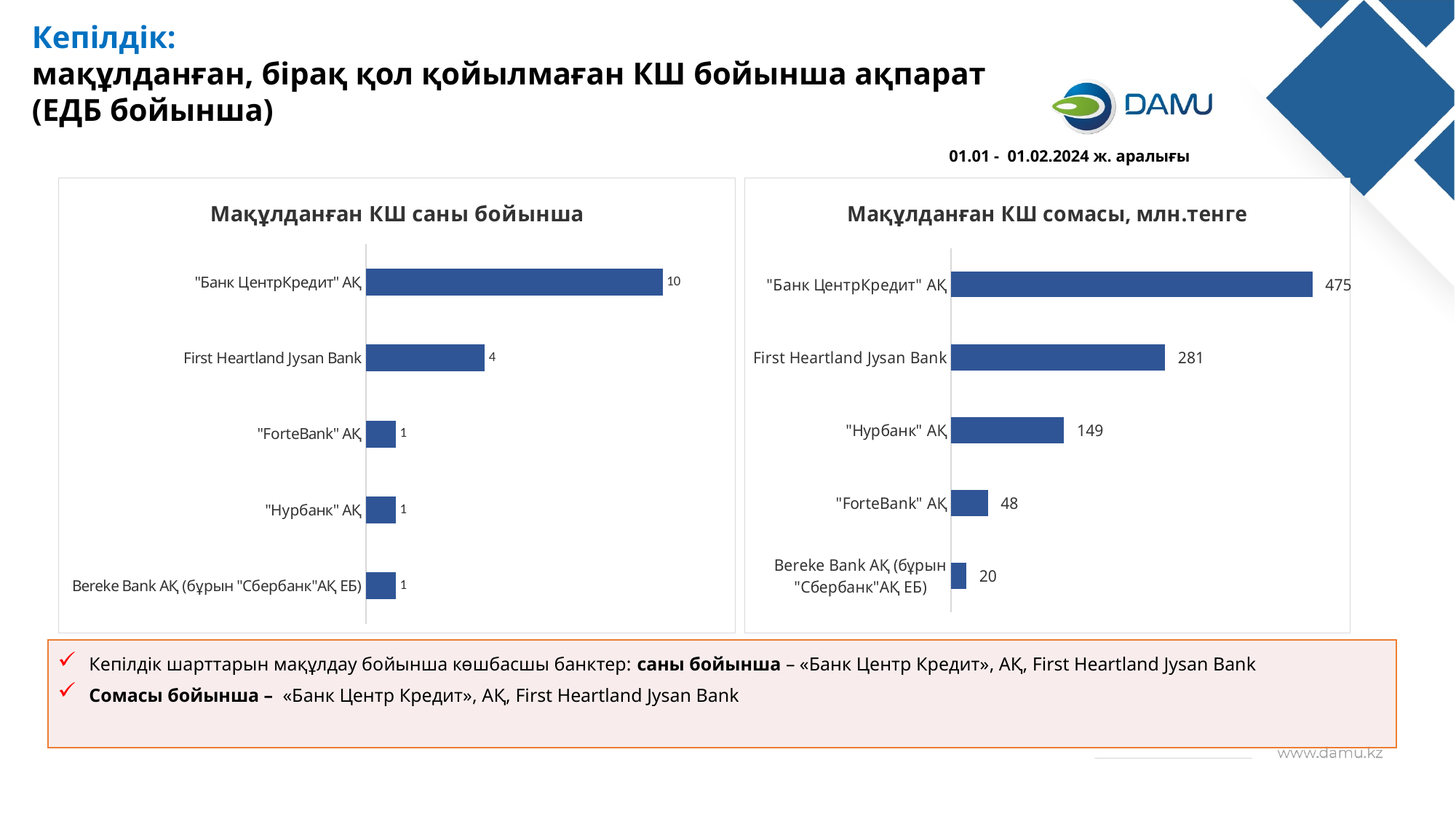
In the chart titled "Мақұлданған КШ саны бойынша", which bank has the highest value? "Банк ЦентрКредит" АҚ In the chart titled "Мақұлданған КШ сомасы, млн.тенге", which bank has the lowest value? Bereke Bank АҚ (бұрын "Сбербанк"АҚ ЕБ) In the chart titled "Мақұлданған КШ саны бойынша", what is the value for "Банк ЦентрКредит" АҚ? 10 What is the title of the left chart on the slide? Мақұлданған КШ саны бойынша In the chart titled "Мақұлданған КШ саны бойынша", what is the value for First Heartland Jysan Bank? 4 In the chart titled "Мақұлданған КШ саны бойынша", how many banks are shown? 5 What type of chart is the chart titled "Мақұлданған КШ сомасы, млн.тенге"? Bar chart In the chart titled "Мақұлданған КШ сомасы, млн.тенге", what is the value for "Нурбанк" АҚ? 149 In the chart titled "Мақұлданған КШ сомасы, млн.тенге", what is the difference between "Банк ЦентрКредит" АҚ and First Heartland Jysan Bank? 194 In the chart titled "Мақұлданған КШ саны бойынша", what is the difference between "Банк ЦентрКредит" АҚ and First Heartland Jysan Bank? 6 In the chart titled "Мақұлданған КШ сомасы, млн.тенге", what is the value for Bereke Bank АҚ (бұрын "Сбербанк"АҚ ЕБ)? 20 In the chart titled "Мақұлданған КШ сомасы, млн.тенге", which is larger, the value for "Нурбанк" АҚ or "ForteBank" АҚ? "Нурбанк" АҚ